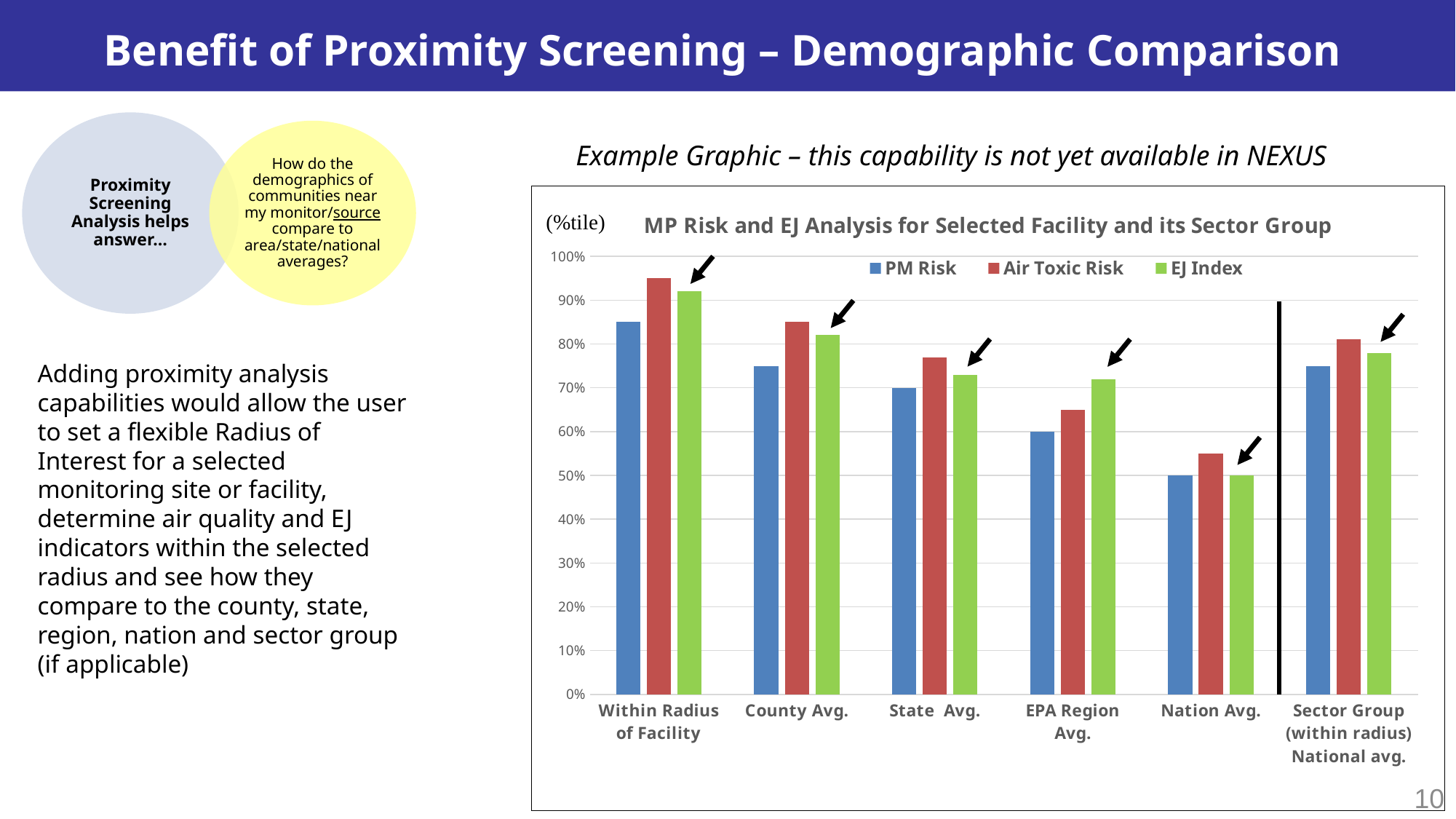
How many categories are shown along the x axis of the chart? 6 What is the title of the chart? MP Risk and EJ Analysis for Selected Facility and its Sector Group Which category has the lowest PM Risk value? Nation Avg. What is the PM Risk value for State Avg.? 70% What is the PM Risk value for Nation Avg.? 50% Is the EJ Index value for EPA Region Avg. greater or less than 70%? greater Which category has the highest Air Toxic Risk value? Within Radius of Facility Is the Air Toxic Risk value for Within Radius of Facility greater or less than 90%? greater What type of chart is shown on the slide? bar chart How many series does the chart legend list? 3 Which is larger, the PM Risk value for Within Radius of Facility or for County Avg.? Within Radius of Facility What is the PM Risk value for EPA Region Avg.? 60%